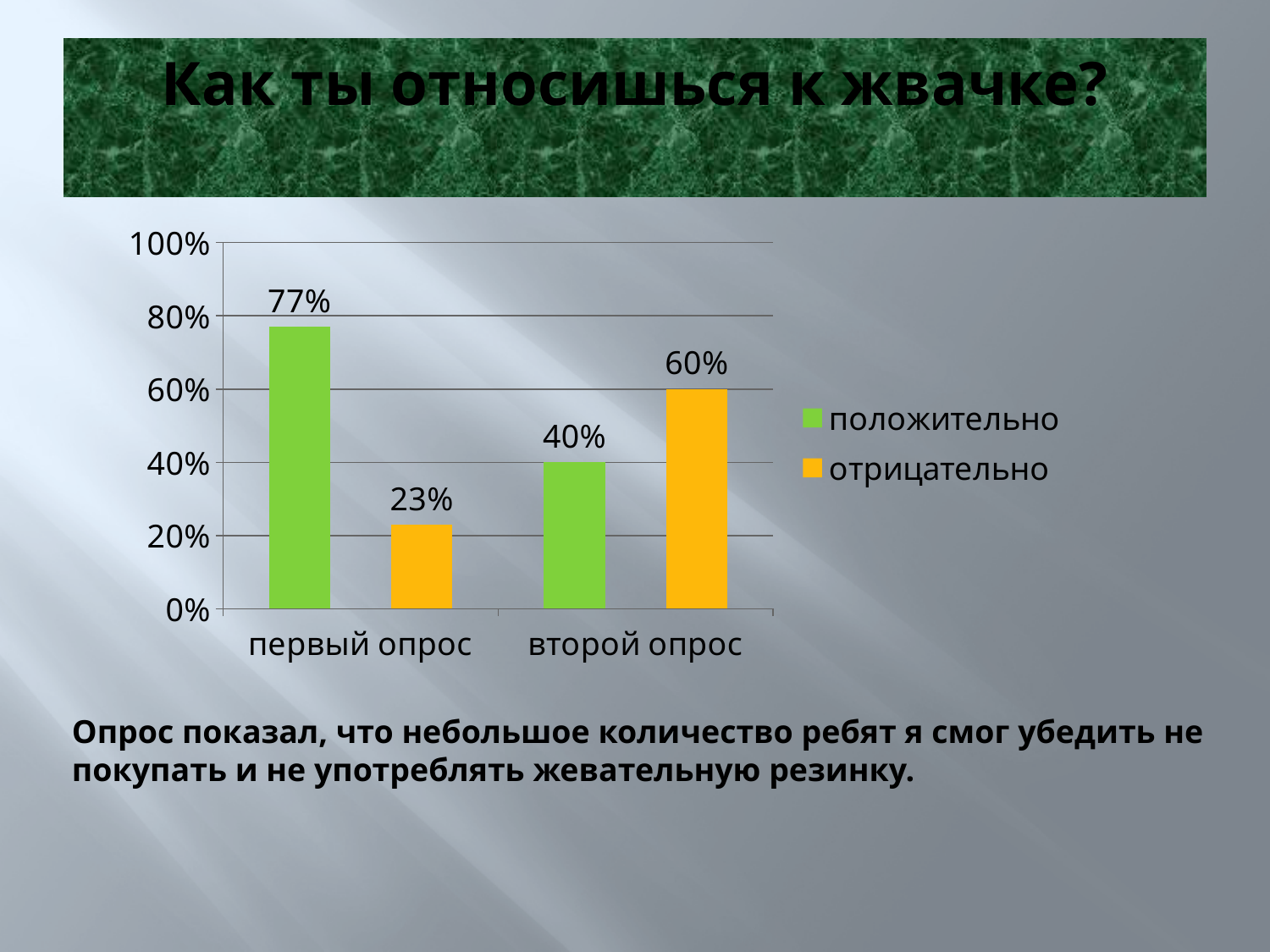
What is the difference between положительно and отрицательно in первый опрос? 54% What is the value for отрицательно in второй опрос? 60% How many series does the legend list? 2 What is the value for отрицательно in первый опрос? 23% What is the difference between отрицательно in второй опрос and отрицательно in первый опрос? 37% Which is larger in второй опрос: положительно or отрицательно? отрицательно What is the value for положительно in второй опрос? 40% Does the value for положительно rise or fall from первый опрос to второй опрос? fall What is the value for положительно in первый опрос? 77% What kind of chart is shown on the slide? bar chart Which bar has the highest value on the chart? положительно, первый опрос Which bar has the lowest value on the chart? отрицательно, первый опрос